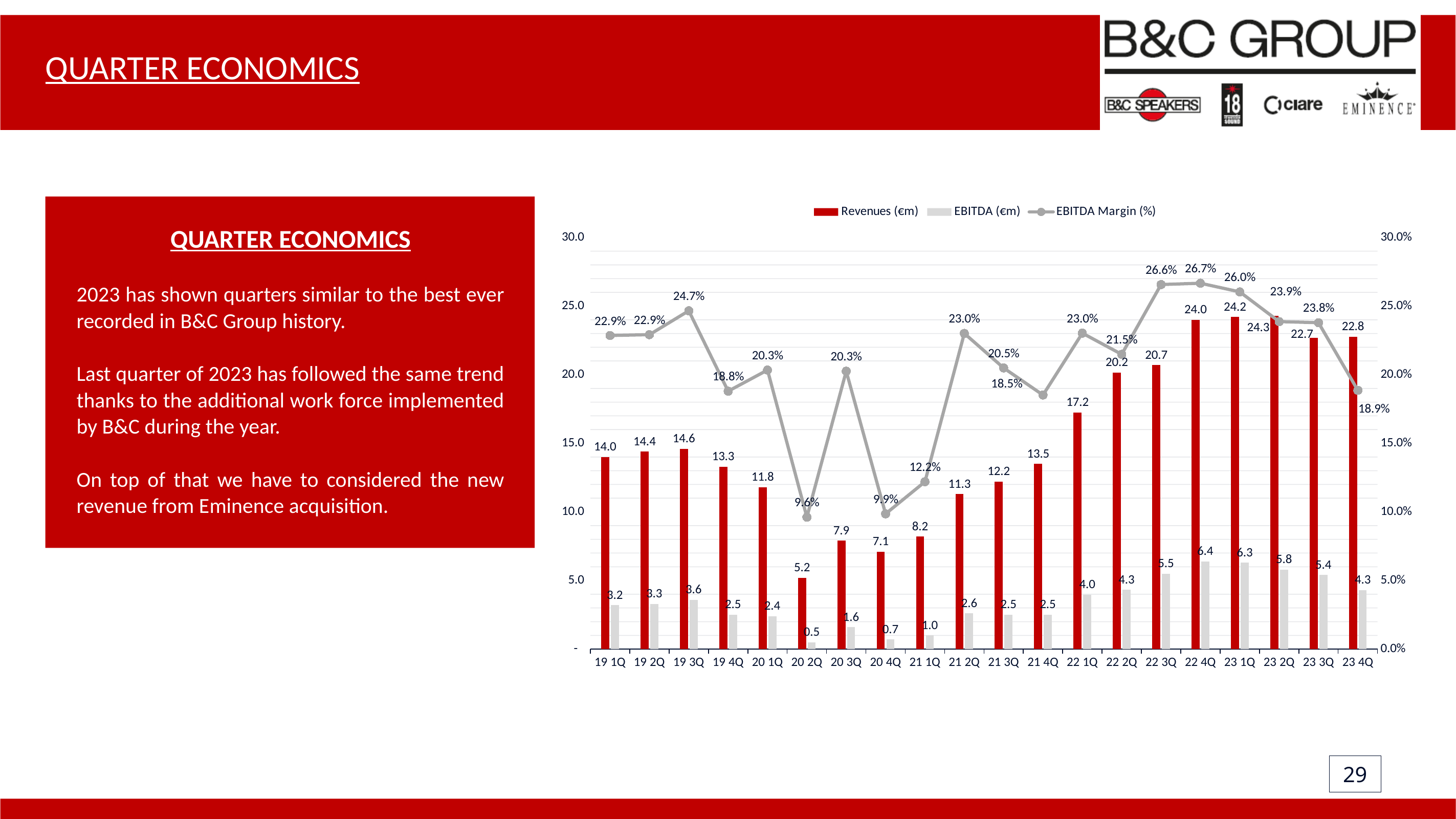
What is the Revenues (€m) value for 23 4Q? 22.8 How many series does the legend list? 3 Do Revenues (€m) rise or fall from 20 2Q to 22 4Q? Rise How many quarters are shown on the x axis? 20 What is the EBITDA Margin (%) for 20 2Q? 9.6% Which is larger, the EBITDA (€m) for 23 1Q or for 23 2Q? 23 1Q What is the EBITDA (€m) value for 22 4Q? 6.4 Which quarter has the highest Revenues (€m)? 23 2Q What kind of chart is used for the Revenues (€m) series? Bar chart Which quarter has the highest EBITDA Margin (%)? 22 4Q What is the difference in Revenues (€m) between 22 1Q and 21 4Q? 3.7 Which quarter has the lowest EBITDA (€m)? 20 2Q